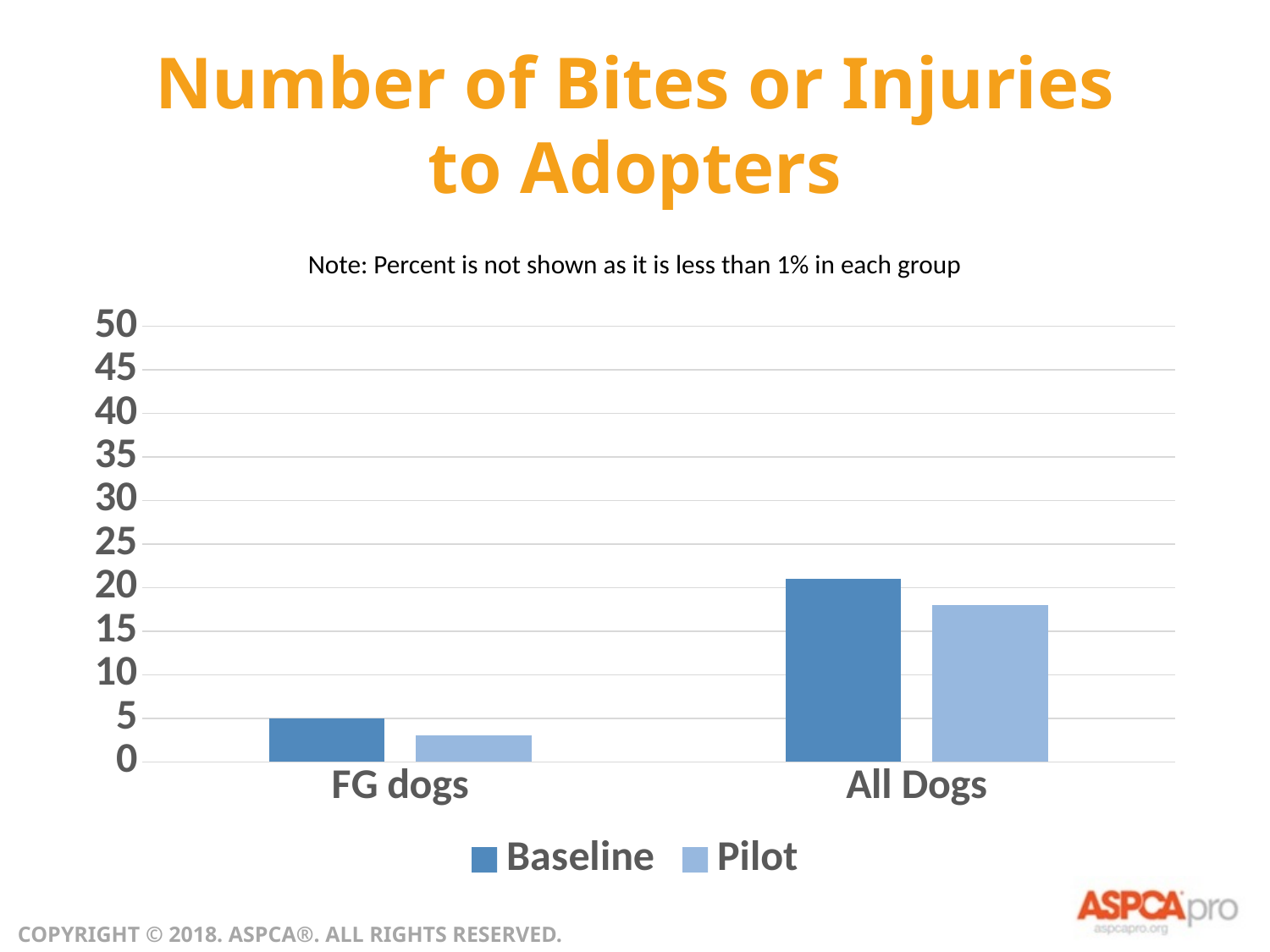
What kind of chart is shown on the slide? Bar chart How many categories are shown on the x axis? 2 Which bar is the highest in the chart? All Dogs, Baseline How many series does the legend list? 2 Which series is shown in the darker blue colour? Baseline Is the Pilot value for All Dogs greater or less than 20? less What is the title of the chart? Number of Bites or Injuries to Adopters Is the Baseline value for All Dogs greater or less than 20? greater For All Dogs, which is larger, the Baseline or the Pilot value? Baseline Is the Pilot value for FG dogs greater or less than 5? less Which bar is the lowest in the chart? FG dogs, Pilot What is the Baseline value for FG dogs? 5